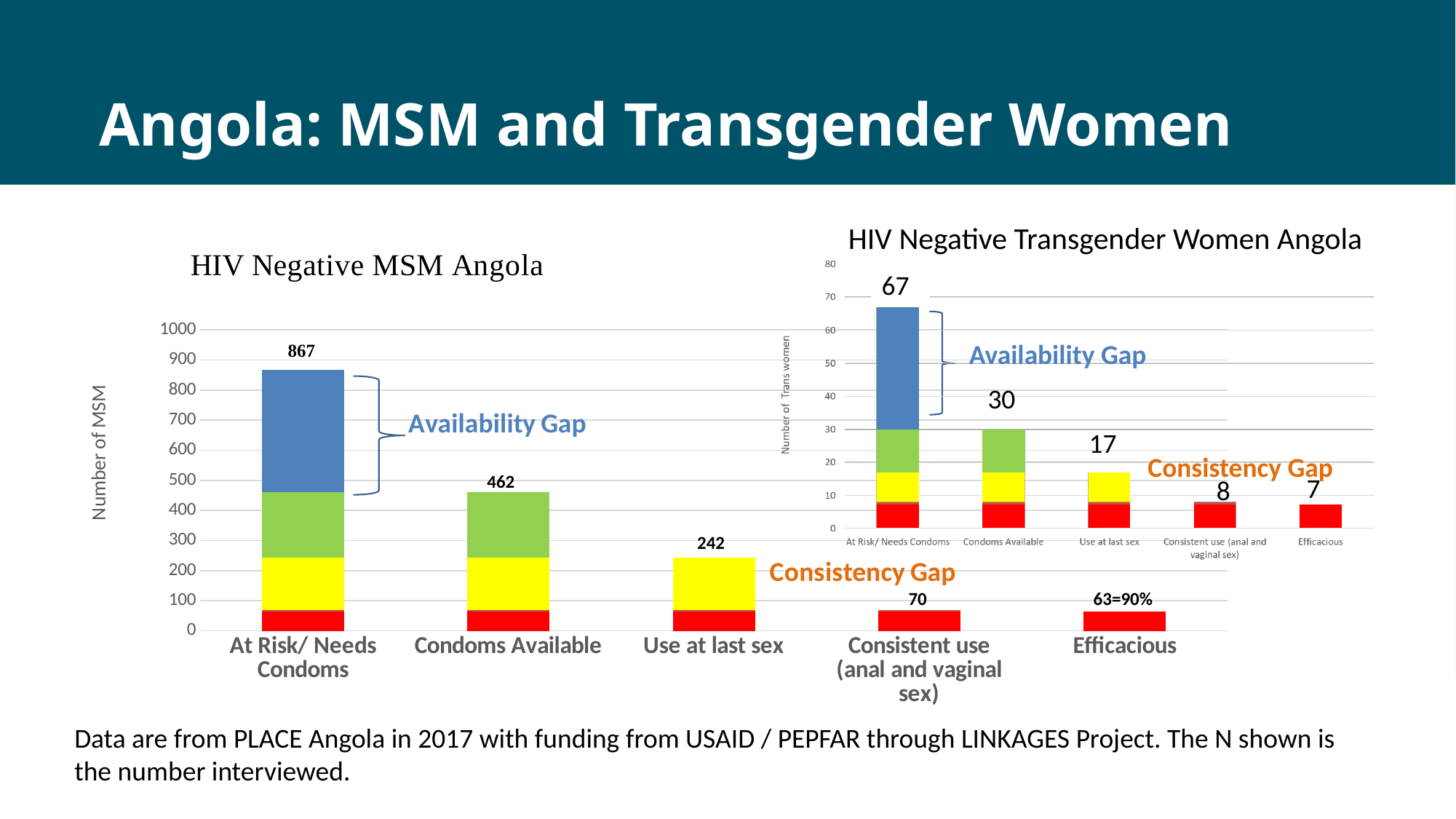
In the 'HIV Negative Transgender Women Angola' chart, what is the value labelled for 'At Risk/ Needs Condoms'? 67 What type of chart is the 'HIV Negative MSM Angola' chart? bar chart Do the labelled values in the 'HIV Negative Transgender Women Angola' chart rise or fall from left to right along the x axis? fall In the 'HIV Negative MSM Angola' chart, what is the value labelled for 'Use at last sex'? 242 In the 'HIV Negative MSM Angola' chart, what is the difference between the 'At Risk/ Needs Condoms' value and the 'Condoms Available' value? 405 In the 'HIV Negative Transgender Women Angola' chart, what is the value labelled for 'Condoms Available'? 30 In the 'HIV Negative MSM Angola' chart, how many categories are shown on the x axis? 5 In the 'HIV Negative Transgender Women Angola' chart, what is the difference between the 'Use at last sex' value and the 'Consistent use (anal and vaginal sex)' value? 9 In the 'HIV Negative MSM Angola' chart, what is the value labelled for 'At Risk/ Needs Condoms'? 867 In the 'HIV Negative MSM Angola' chart, what is the value labelled for 'Consistent use (anal and vaginal sex)'? 70 In the 'HIV Negative MSM Angola' chart, which category has the lowest labelled value? Efficacious In the 'HIV Negative Transgender Women Angola' chart, which is larger: the value for 'Consistent use (anal and vaginal sex)' or the value for 'Efficacious'? Consistent use (anal and vaginal sex)